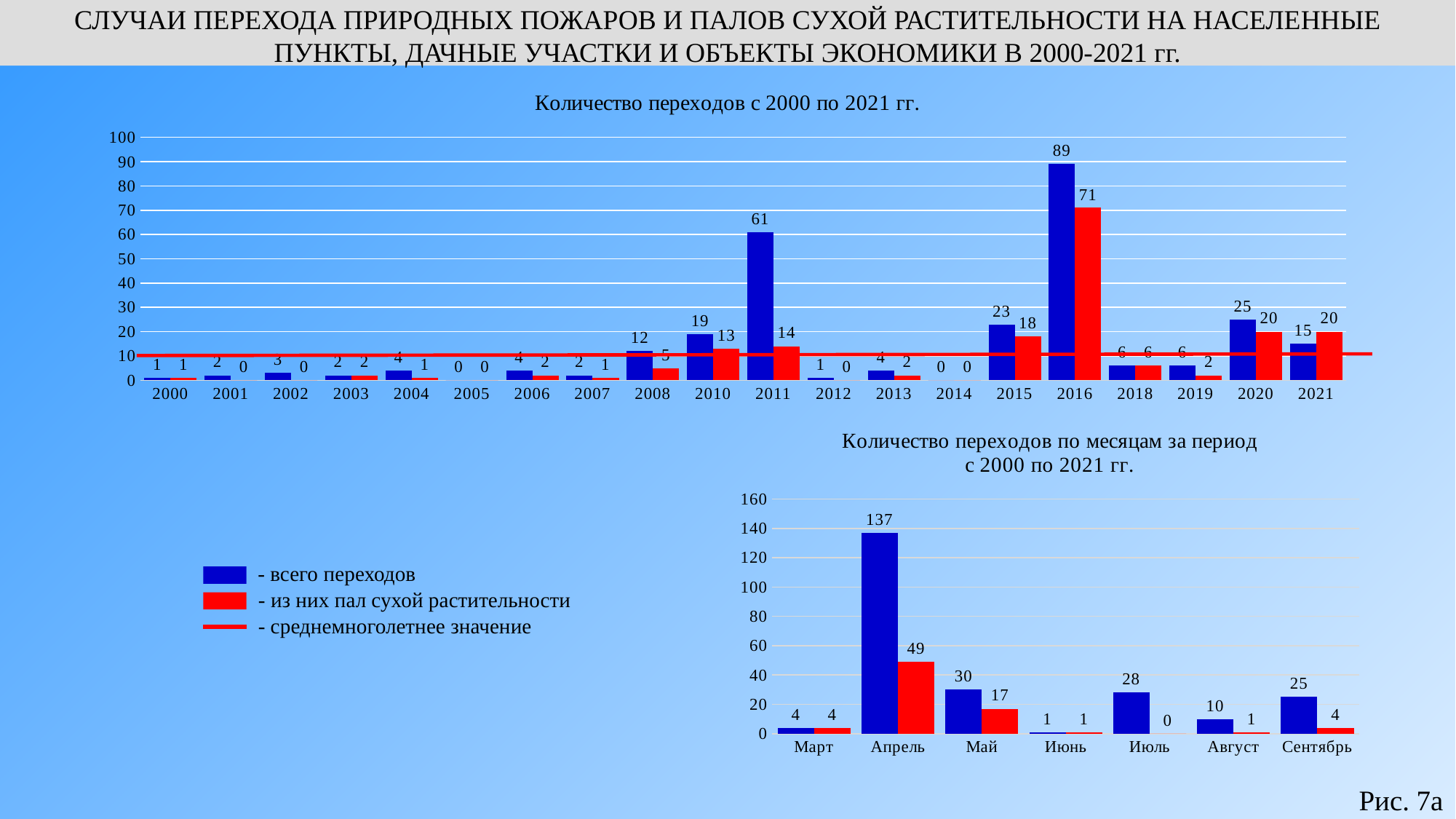
In the chart 'Количество переходов по месяцам за период с 2000 по 2021 гг.', which month has the lowest value of 'всего переходов'? Июнь In the chart 'Количество переходов с 2000 по 2021 гг.', which year has the highest value of 'всего переходов'? 2016 How many entries does the legend on the slide list? 3 In the chart 'Количество переходов с 2000 по 2021 гг.', how many years are shown on the x axis? 20 In the chart 'Количество переходов с 2000 по 2021 гг.', which is larger in 2021: 'всего переходов' or 'из них пал сухой растительности'? из них пал сухой растительности In the chart 'Количество переходов по месяцам за период с 2000 по 2021 гг.', what is the value of 'всего переходов' for Апрель? 137 In the chart 'Количество переходов по месяцам за период с 2000 по 2021 гг.', how many months are shown on the x axis? 7 In the chart 'Количество переходов с 2000 по 2021 гг.', what is the value of 'из них пал сухой растительности' for 2011? 14 In the chart 'Количество переходов с 2000 по 2021 гг.', what is the difference between 'всего переходов' and 'из них пал сухой растительности' in 2016? 18 In the chart 'Количество переходов с 2000 по 2021 гг.', what is the value of 'всего переходов' for 2016? 89 In the chart 'Количество переходов по месяцам за период с 2000 по 2021 гг.', what is the difference between 'всего переходов' for Май and Июль? 2 What kind of chart is 'Количество переходов по месяцам за период с 2000 по 2021 гг.'? bar chart